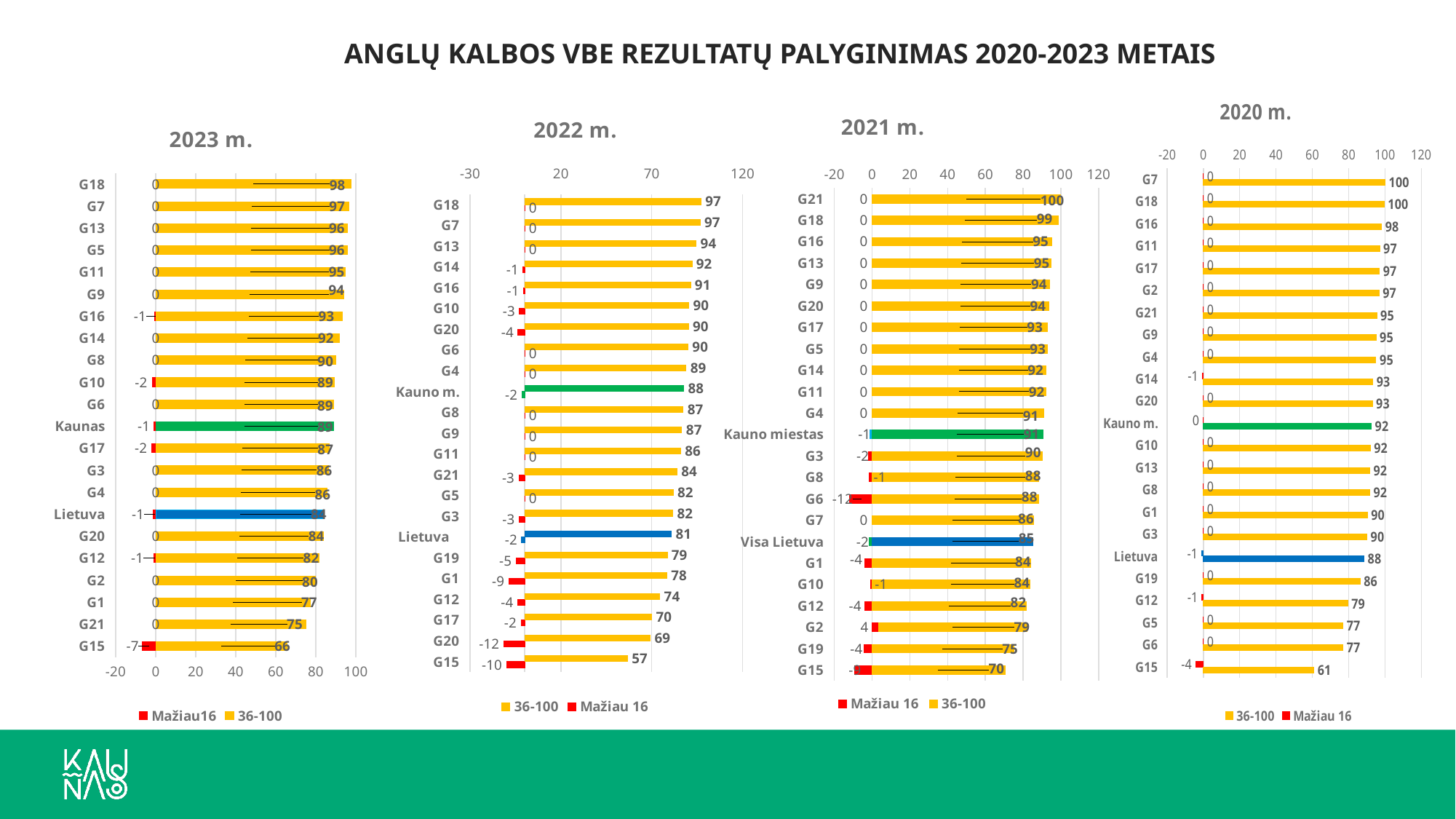
In the 2023 m. chart, what is the 36-100 value for G18? 98 In the 2020 m. chart, what is the 36-100 value for G15? 61 In the 2020 m. chart, what is the 36-100 value for Lietuva? 88 How many series does the legend of the 2023 m. chart list? 2 In the 2022 m. chart, what is the difference between the 36-100 values of G18 and G15? 40 In the 2021 m. chart, which category has the highest 36-100 value? G21 What kind of chart is the 2023 m. chart? Bar chart In the 2022 m. chart, which category has the lowest 36-100 value? G15 How many charts are shown on the slide? 4 In the 2023 m. chart, what is the Mažiau16 value for G15? -7 In the 2021 m. chart, which has the larger 36-100 value, Kauno miestas or Visa Lietuva? Kauno miestas